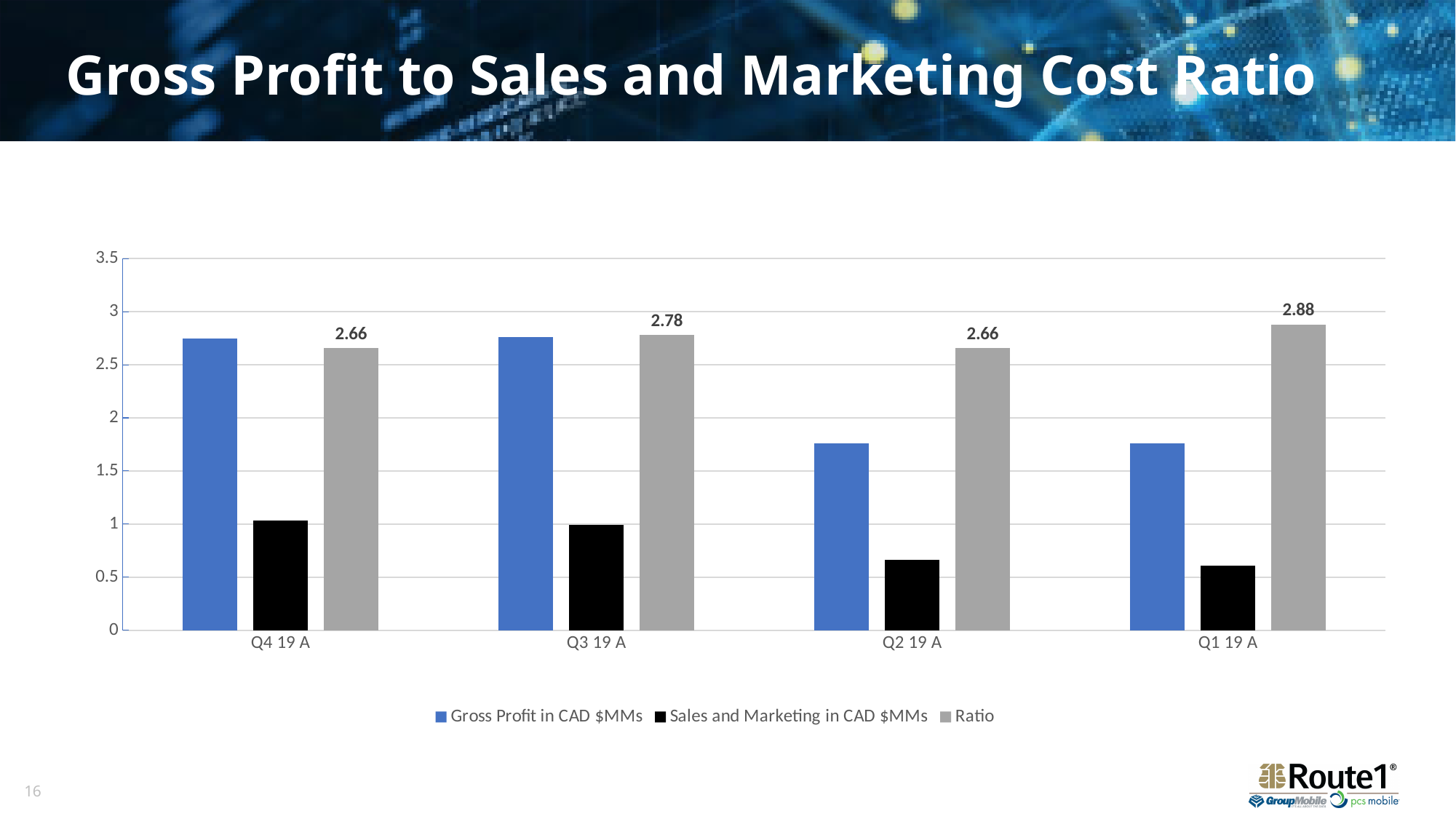
Which quarter has the larger Ratio, Q3 19 A or Q2 19 A? Q3 19 A What is the Ratio value for Q3 19 A? 2.78 How many quarters have a Ratio of 2.66? 2 What is the difference between the Ratio for Q1 19 A and the Ratio for Q3 19 A? 0.10 How many series does the legend list? 3 What kind of chart is shown on the slide? bar chart Is the Sales and Marketing in CAD $MMs for Q2 19 A greater or less than 1? less How many quarters are shown on the x axis of the chart? 4 What is the Ratio value for Q1 19 A? 2.88 Is the Gross Profit in CAD $MMs for Q4 19 A greater or less than 2.5? greater Which quarter has the highest Ratio? Q1 19 A Is the Gross Profit in CAD $MMs for Q2 19 A greater or less than 2? less